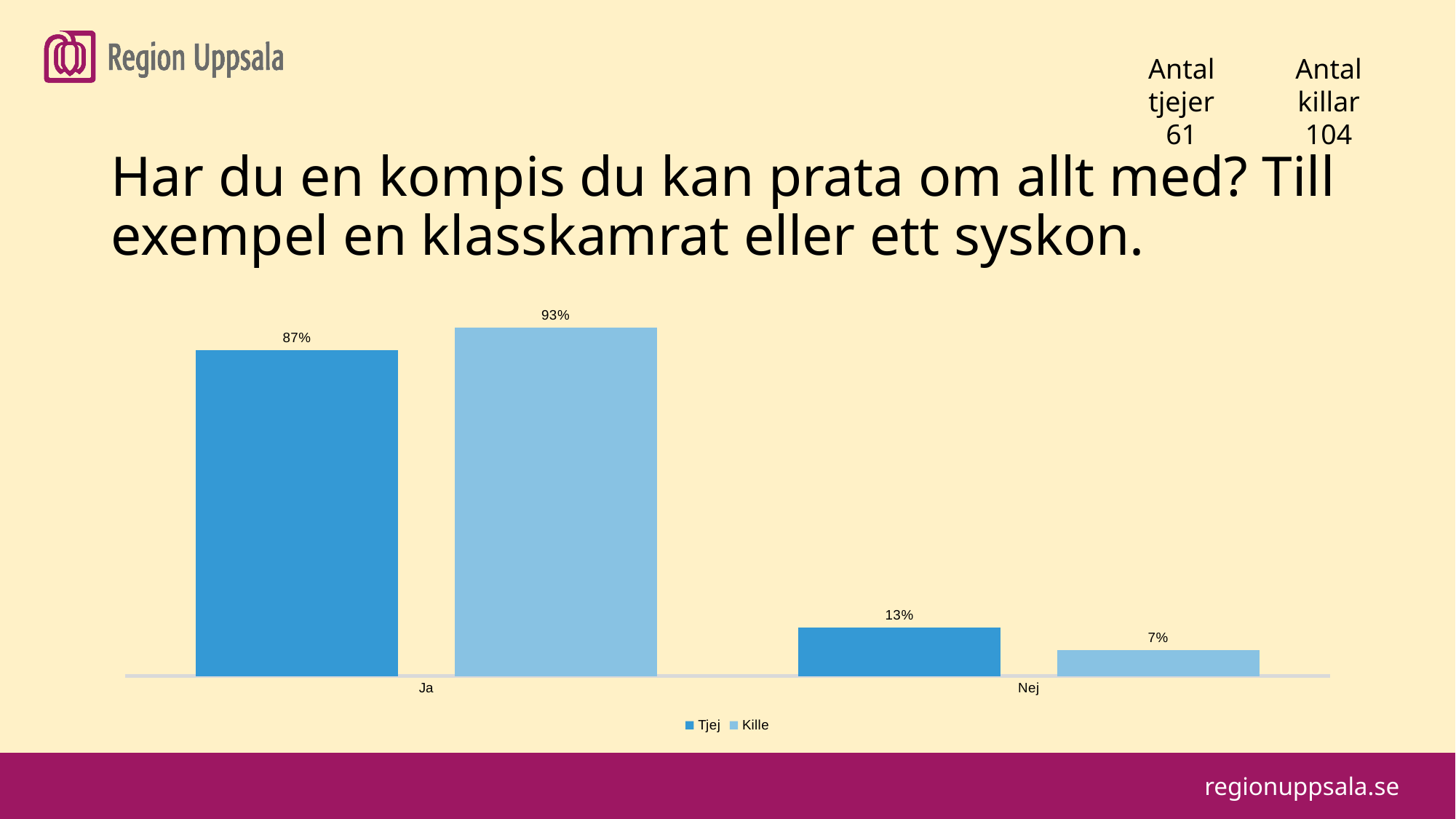
How many categories are shown on the x axis? 2 How many series does the legend list? 2 Which is larger: the Tjej value for Ja or the Tjej value for Nej? Ja Which series has the highest value in the Ja category? Kille What is the difference between the Kille and Tjej values in the Ja category? 6% What is the difference between the Tjej and Kille values in the Nej category? 6% What is the value for Tjej in the Nej category? 13% What is the value for Kille in the Nej category? 7% What is the value for Kille in the Ja category? 93% What kind of chart is shown on the slide? Bar chart Which series has the lowest value in the Nej category? Kille What is the value for Tjej in the Ja category? 87%